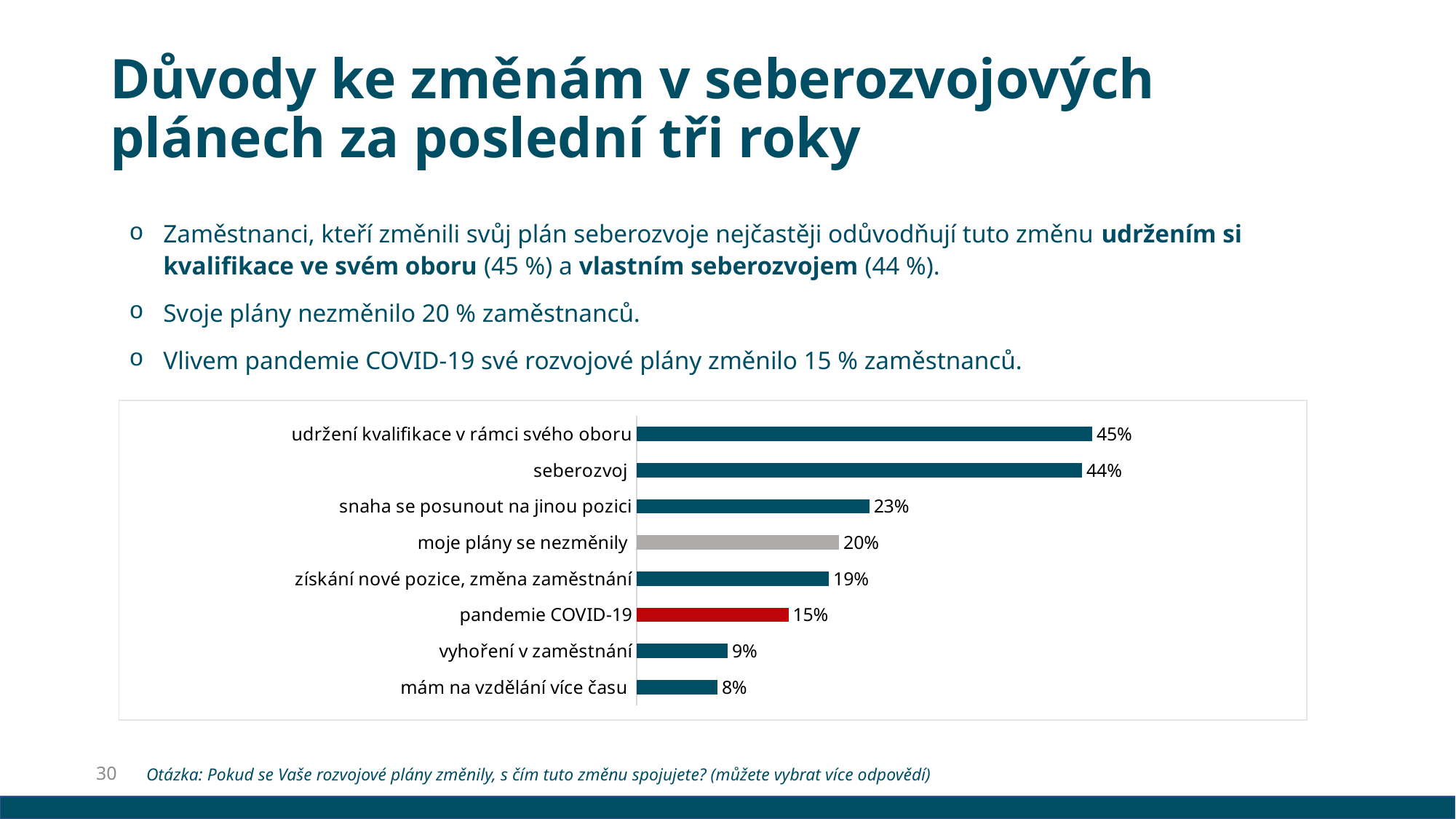
What is the difference between 'snaha se posunout na jinou pozici' and 'získání nové pozice, změna zaměstnání'? 4% What is the difference between 'udržení kvalifikace v rámci svého oboru' and 'seberozvoj'? 1% What is the value for 'udržení kvalifikace v rámci svého oboru'? 45% Which category has the highest value? udržení kvalifikace v rámci svého oboru What is the value for 'pandemie COVID-19'? 15% What is the value for 'moje plány se nezměnily'? 20% Which is larger, 'vyhoření v zaměstnání' or 'pandemie COVID-19'? pandemie COVID-19 How many categories are shown in the chart? 8 What kind of chart is shown on the slide? bar chart Which category has the lowest value? mám na vzdělání více času Which bar in the chart is coloured grey? moje plány se nezměnily Which bar in the chart is coloured red? pandemie COVID-19